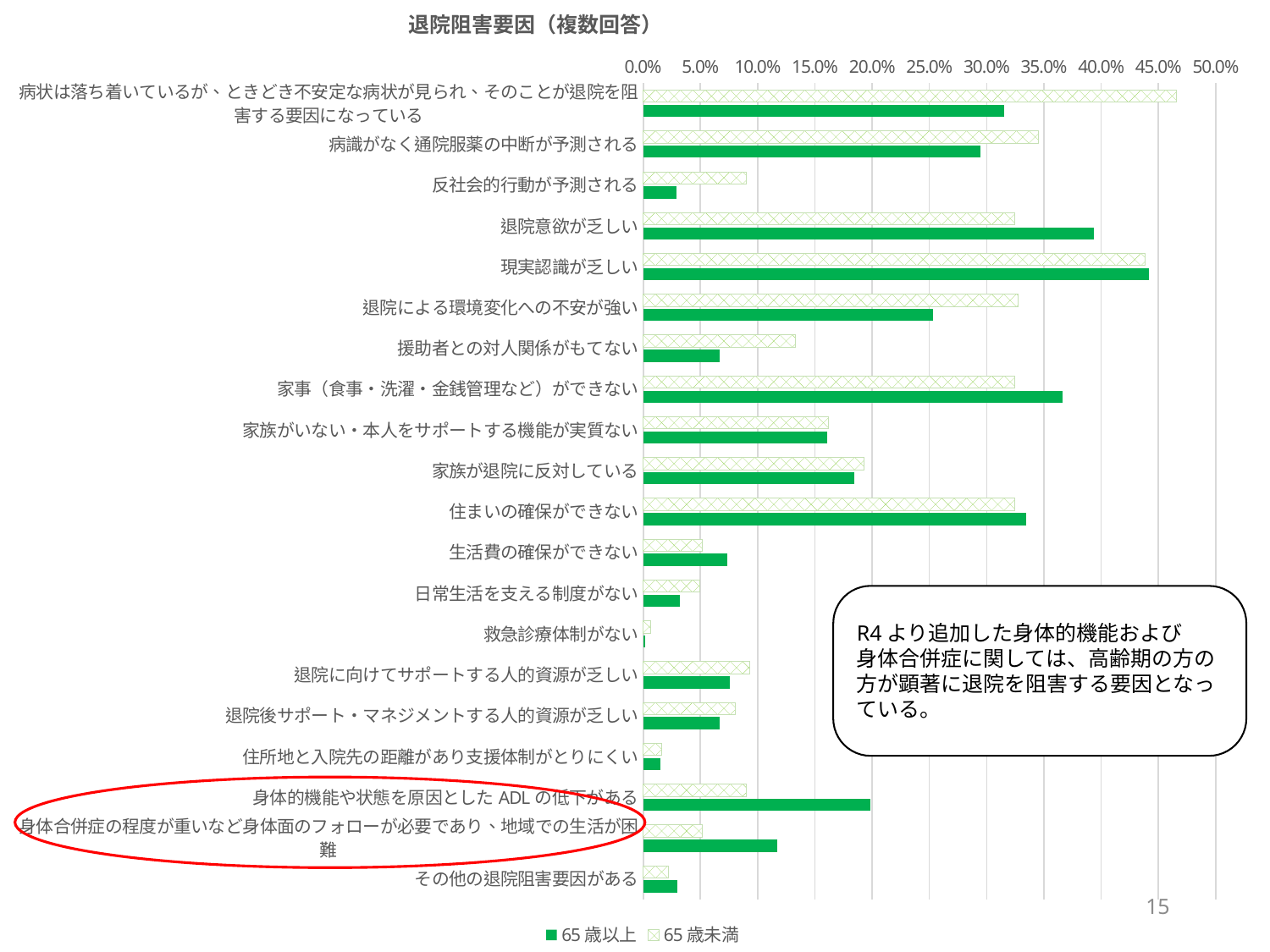
For 病識がなく通院服薬の中断が予測される, which series has the larger value, 65歳以上 or 65歳未満? 65歳未満 For 身体的機能や状態を原因としたADLの低下がある, which series has the larger value, 65歳以上 or 65歳未満? 65歳以上 Is the 65歳未満 value for 身体的機能や状態を原因としたADLの低下がある greater or less than 10.0%? less Is the 65歳以上 value for 住まいの確保ができない greater or less than 30.0%? greater Is the 65歳以上 value for 現実認識が乏しい greater or less than 40.0%? greater How many series does the legend list? 2 Which category has the highest value for the 65歳以上 series? 現実認識が乏しい What is the title of the chart? 退院阻害要因（複数回答） What kind of chart is shown on the slide? bar chart Which category has the highest value for the 65歳未満 series? 病状は落ち着いているが、ときどき不安定な病状が見られ、そのことが退院を阻害する要因になっている How many categories (discharge-obstructing factors) are plotted on the chart? 20 Which category has the lowest value for the 65歳以上 series? 救急診療体制がない